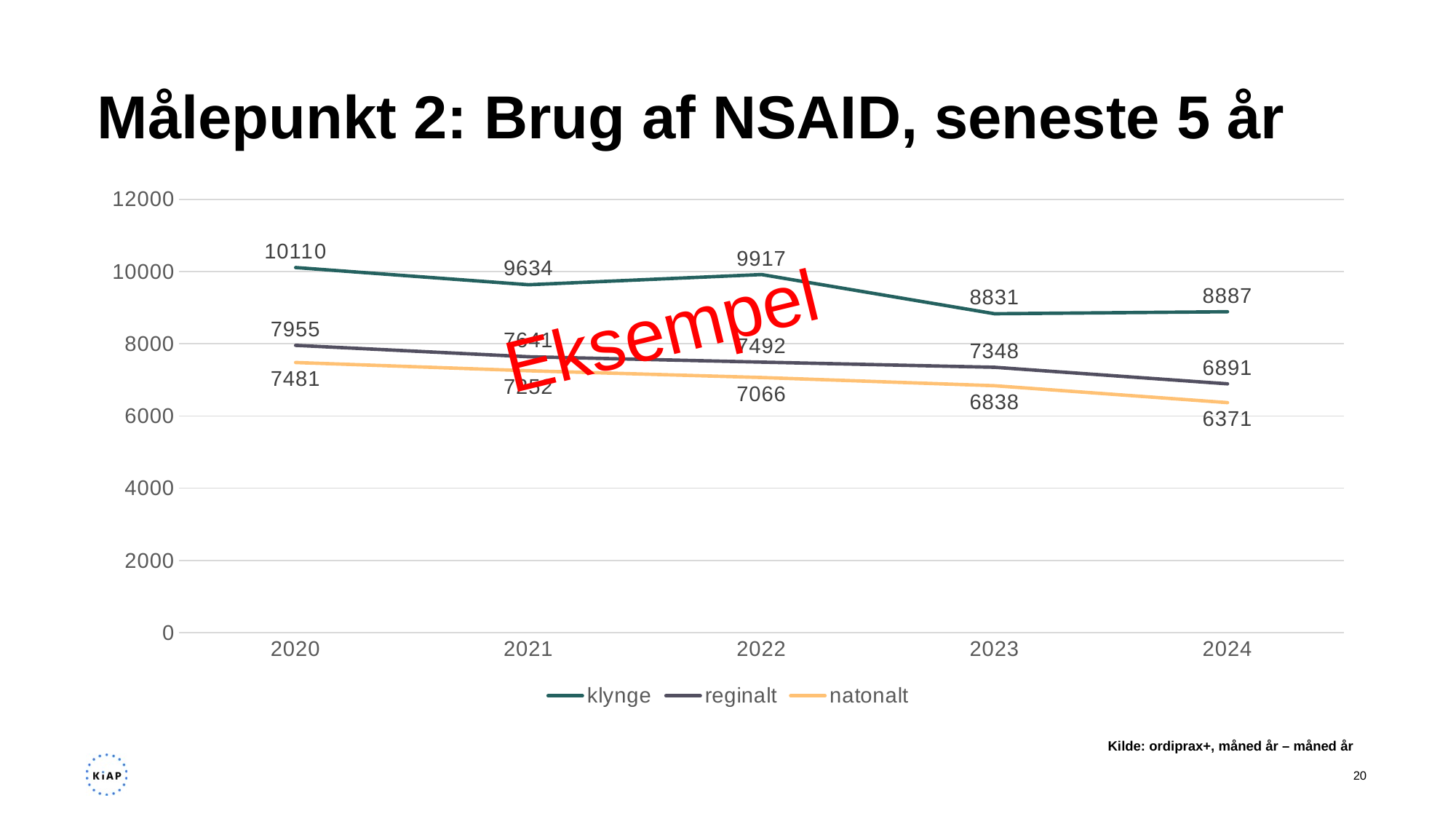
What is the difference between the klynge value in 2020 and in 2024? 1223 What is the value for natonalt in 2024? 6371 Which is larger in 2022, the klynge value or the reginalt value? klynge How many years are shown on the x axis? 5 In which year is the natonalt value lowest? 2024 In which year is the klynge value highest? 2020 Does the natonalt series rise or fall from 2020 to 2024? fall What is the value for klynge in 2020? 10110 How many series does the legend list? 3 What type of chart is shown on the slide? line chart What is the value for reginalt in 2023? 7348 Is the value for reginalt in 2024 greater or less than 8000? less